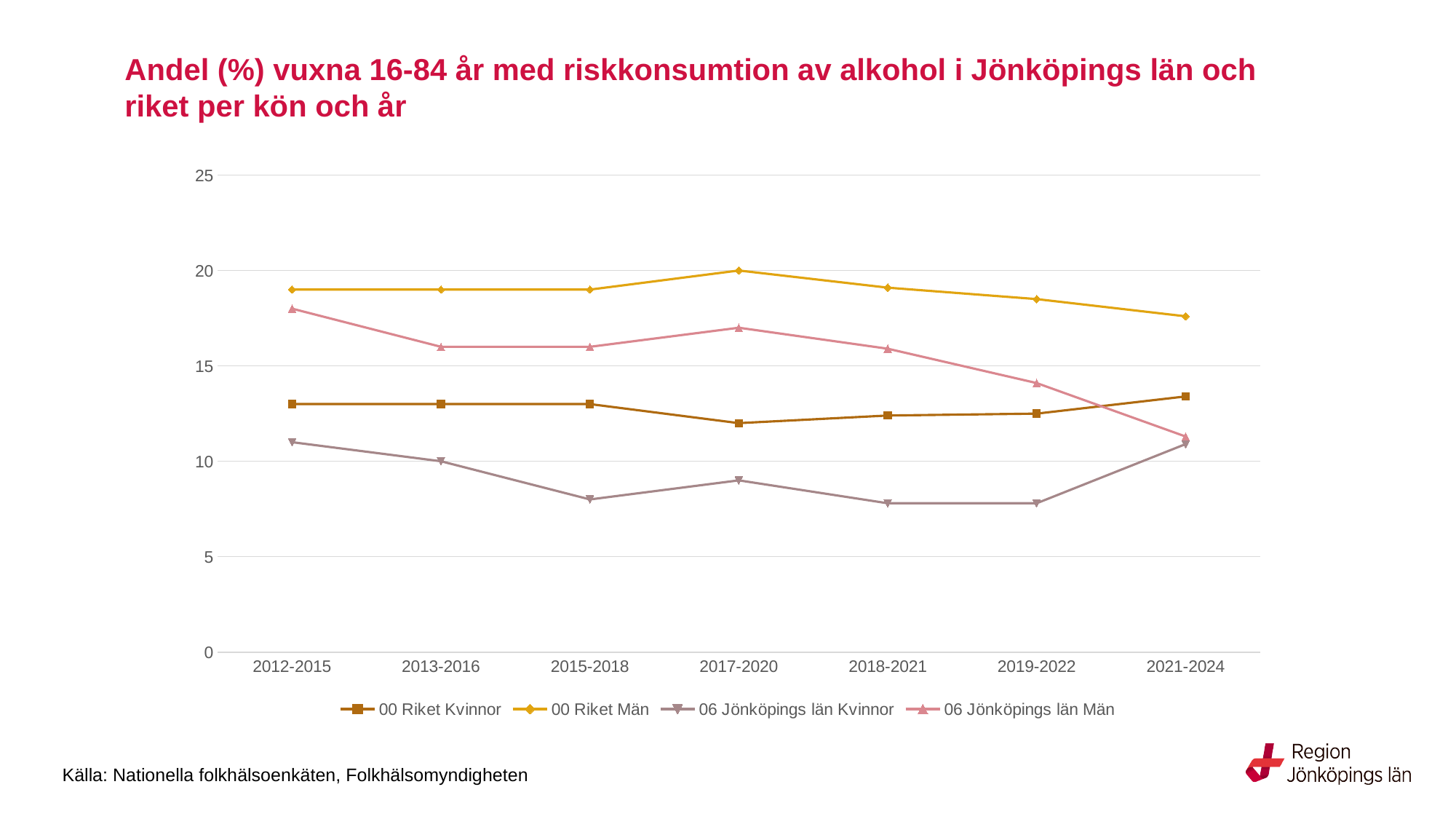
What kind of chart is shown on the slide? line chart Is the value for 00 Riket Män in 2012-2015 greater or less than 15? greater Is the value for 06 Jönköpings län Kvinnor in 2015-2018 greater or less than 10? less In 2012-2015, which is larger: 00 Riket Kvinnor or 06 Jönköpings län Kvinnor? 00 Riket Kvinnor Which series has the lowest value in 2018-2021? 06 Jönköpings län Kvinnor In which period does the 06 Jönköpings län Män series reach its lowest value? 2021-2024 Which series has the highest value in 2012-2015? 00 Riket Män Is the value for 06 Jönköpings län Män in 2021-2024 greater or less than 15? less Does the 06 Jönköpings län Män series rise or fall from 2017-2020 to 2021-2024? fall How many time periods are shown on the x axis? 7 In which period does the 00 Riket Män series reach its highest value? 2017-2020 How many series does the legend list? 4